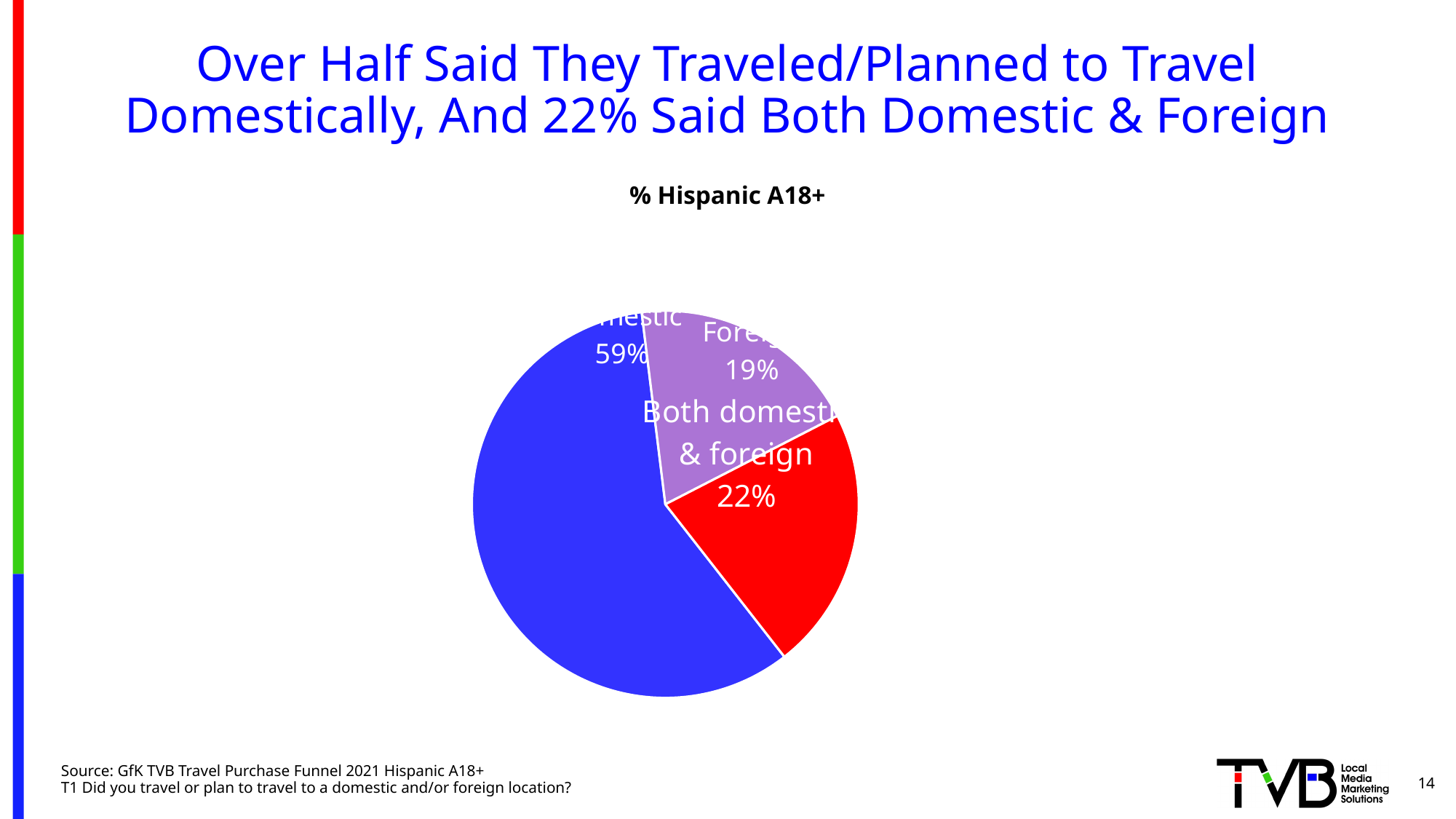
Which slice of the pie is the largest? Domestic What percentage of the pie is the Domestic slice? 59% Which is larger, the 'Both domestic & foreign' slice or the Foreign slice? Both domestic & foreign How many slices does the pie chart have? 3 What is the chart's title? % Hispanic A18+ What colour is the Domestic slice of the pie? blue What kind of chart is shown on the slide? pie chart What percentage of the pie is the 'Both domestic & foreign' slice? 22% What is the difference in percentage points between the Domestic slice and the 'Both domestic & foreign' slice? 37 What percentage of the pie is the Foreign slice? 19% Which slice of the pie is the smallest? Foreign What is the difference in percentage points between the 'Both domestic & foreign' slice and the Foreign slice? 3